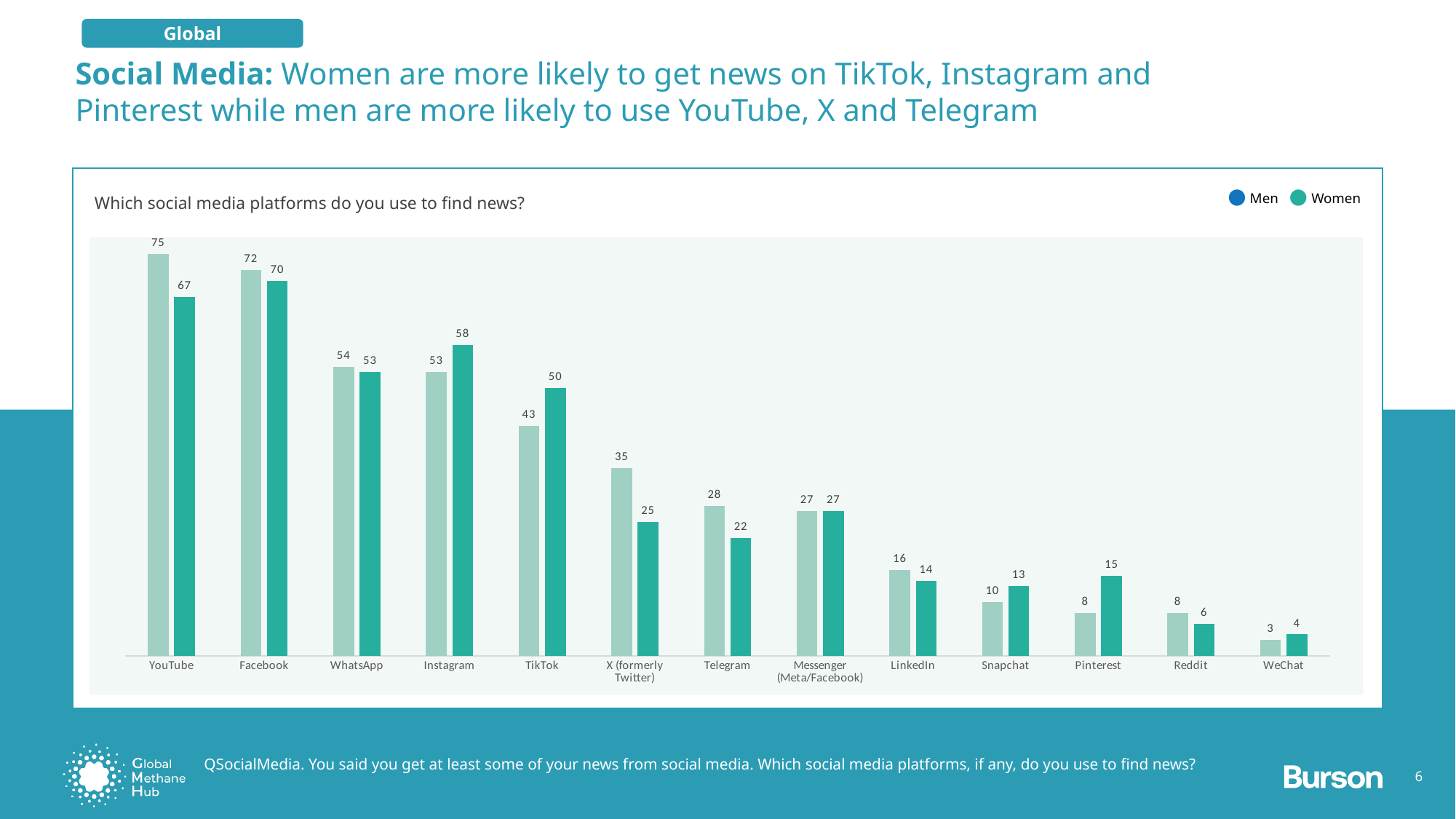
How many series does the legend list? 2 What is the value for Women on Pinterest? 15 What is the difference between Men and Women on Facebook? 2 What is the value for Women on TikTok? 50 What is the value for Men on YouTube? 75 What is the difference between Men and Women on X (formerly Twitter)? 10 What kind of chart is shown? Bar chart Which platform has the highest value for Men? YouTube How many platforms are shown on the x axis? 13 What question is the chart based on, as shown above the chart? Which social media platforms do you use to find news? Which platform has the lowest value for Women? WeChat Which is larger on Instagram, the value for Men or for Women? Women